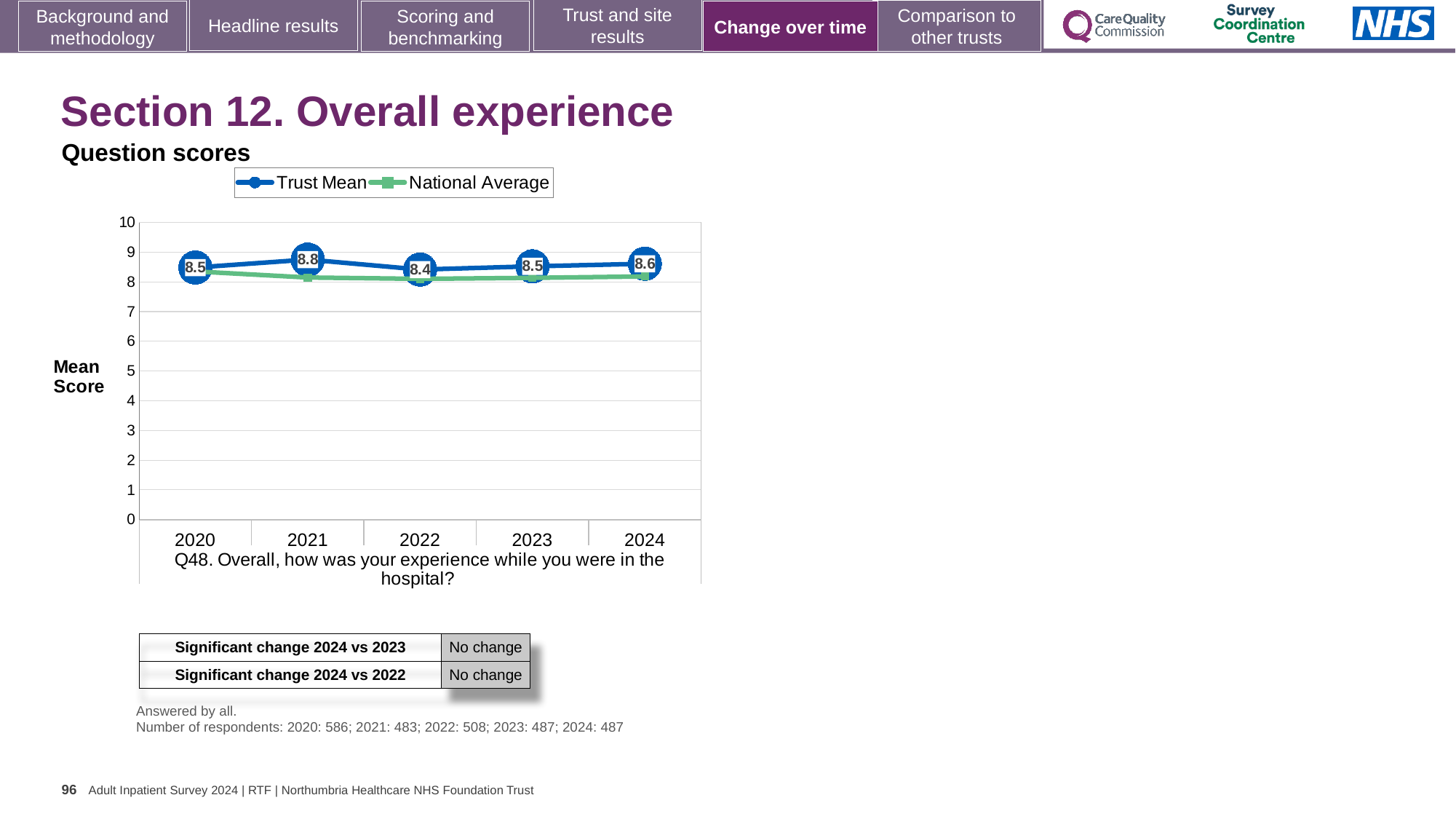
How many series does the legend list? 2 What is the Trust Mean score for 2024? 8.6 Is the National Average value for 2021 greater or less than 9? less Which is larger, the Trust Mean score for 2021 or for 2024? 2021 How many years are plotted on the x axis? 5 Is the National Average value for 2024 greater or less than 7? greater Does the Trust Mean score rise or fall from 2021 to 2022? Fall In which year is the Trust Mean score highest? 2021 In which year is the Trust Mean score lowest? 2022 What is the difference between the Trust Mean scores for 2021 and 2022? 0.4 What kind of chart is shown on the slide? Line chart What is the Trust Mean score for 2021? 8.8